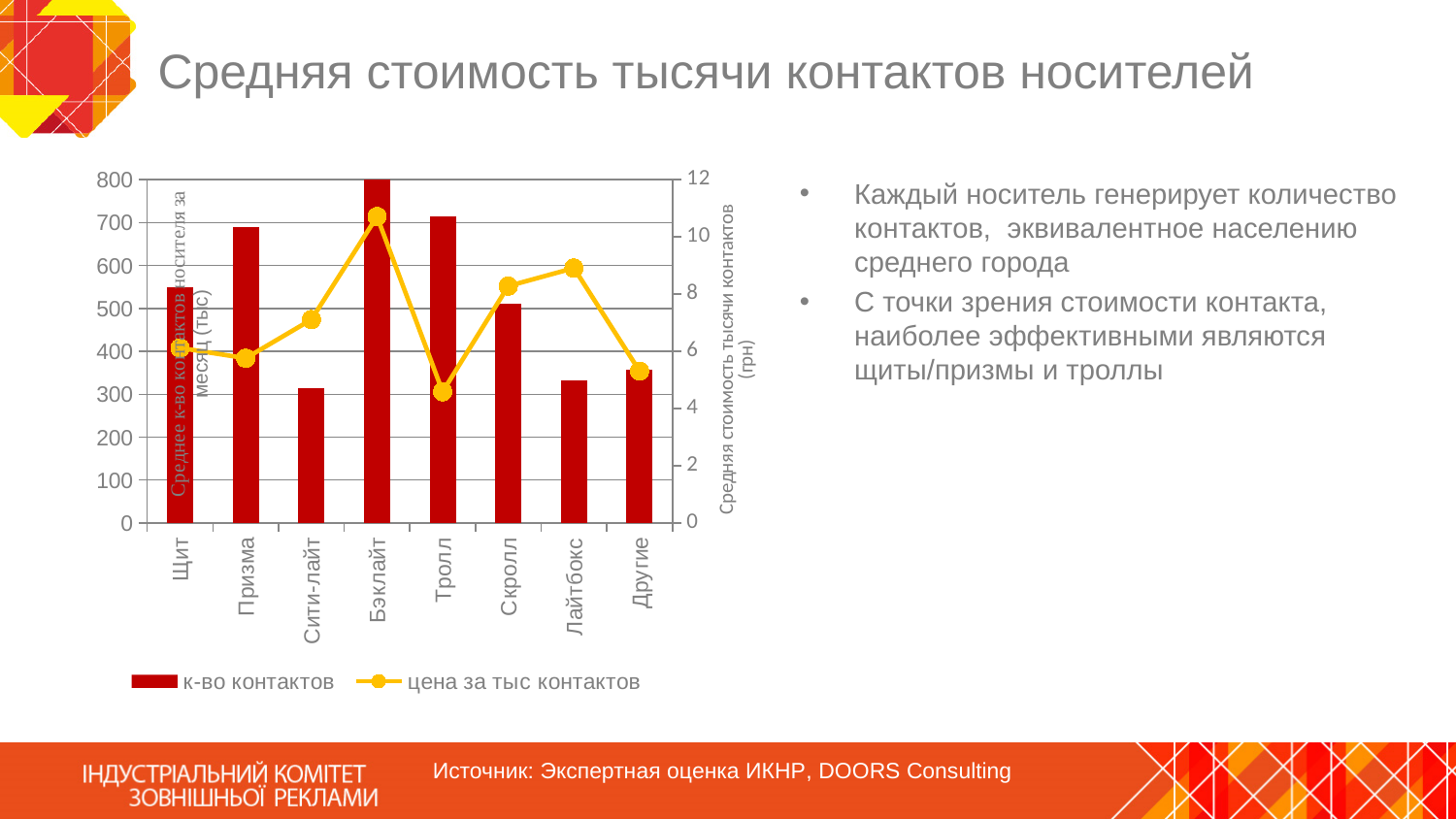
Which category has the highest value on the цена за тыс контактов line? Бэклайт What is the title of the slide containing the chart? Средняя стоимость тысячи контактов носителей Is the цена за тыс контактов value for Тролл greater or less than 6? less Which has the larger к-во контактов bar, Призма or Сити-лайт? Призма Which category has the lowest value on the цена за тыс контактов line? Тролл How many series does the chart legend list? 2 Is the к-во контактов bar for Призма greater or less than 600? greater Is the к-во контактов bar for Сити-лайт greater or less than 400? less How many categories are shown on the x axis of the chart? 8 Which category has the highest bar for к-во контактов? Бэклайт Which has the larger к-во контактов bar, Тролл or Лайтбокс? Тролл